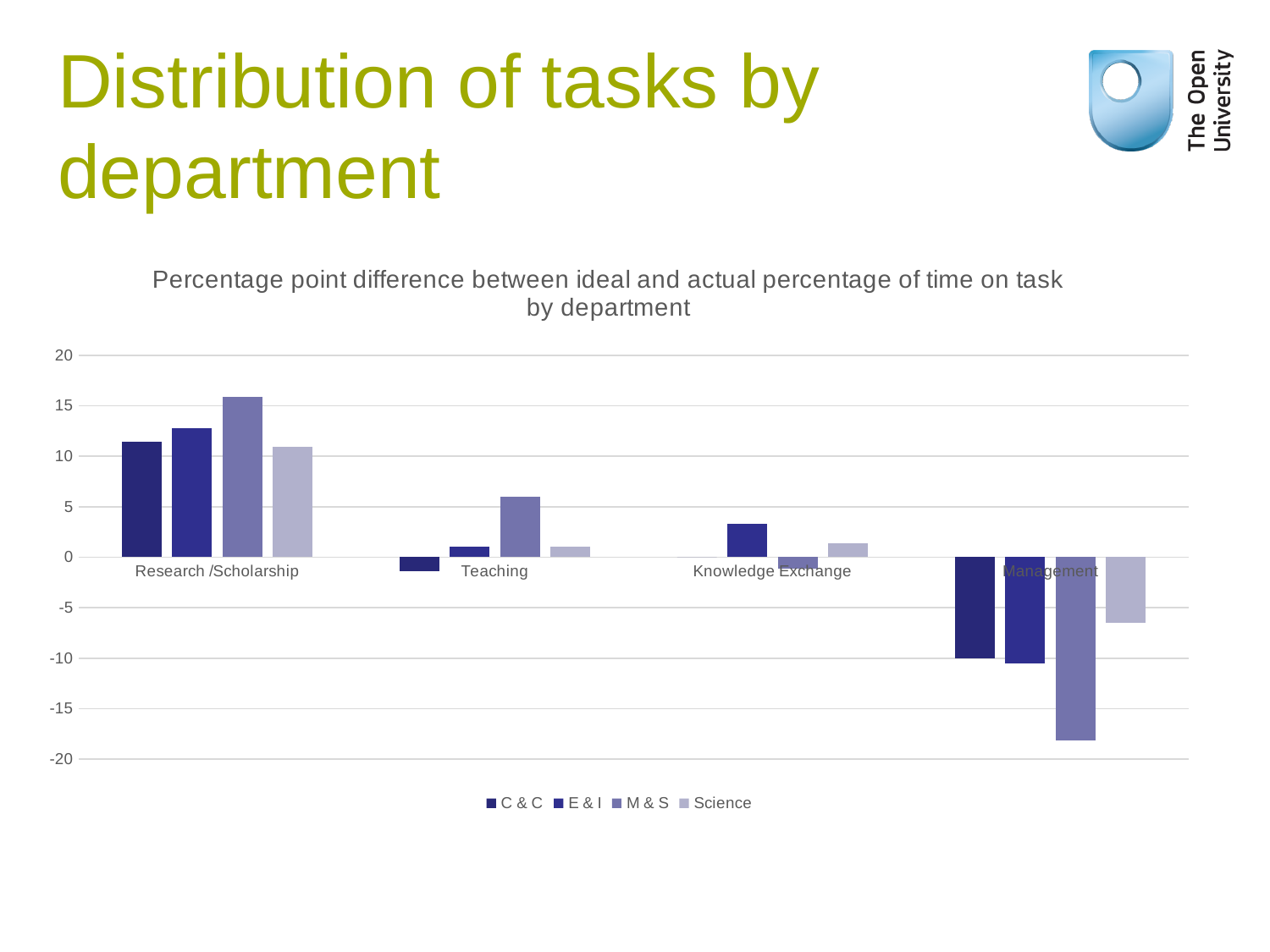
What are the four series listed in the legend? C & C, E & I, M & S, Science Is the value for C & C in Research /Scholarship greater or less than 10? greater Which series has the highest value for Research /Scholarship? M & S How many task categories are shown along the x axis? 4 Is the value for M & S in Research /Scholarship greater or less than 15? greater How many series does the legend list? 4 Is the value for M & S in Management greater or less than -15? less For Teaching, which is larger: the value for M & S or the value for C & C? M & S Which series has the lowest value for Management? M & S What kind of chart is shown on the slide? Bar chart Which task category has the highest values across all series? Research /Scholarship